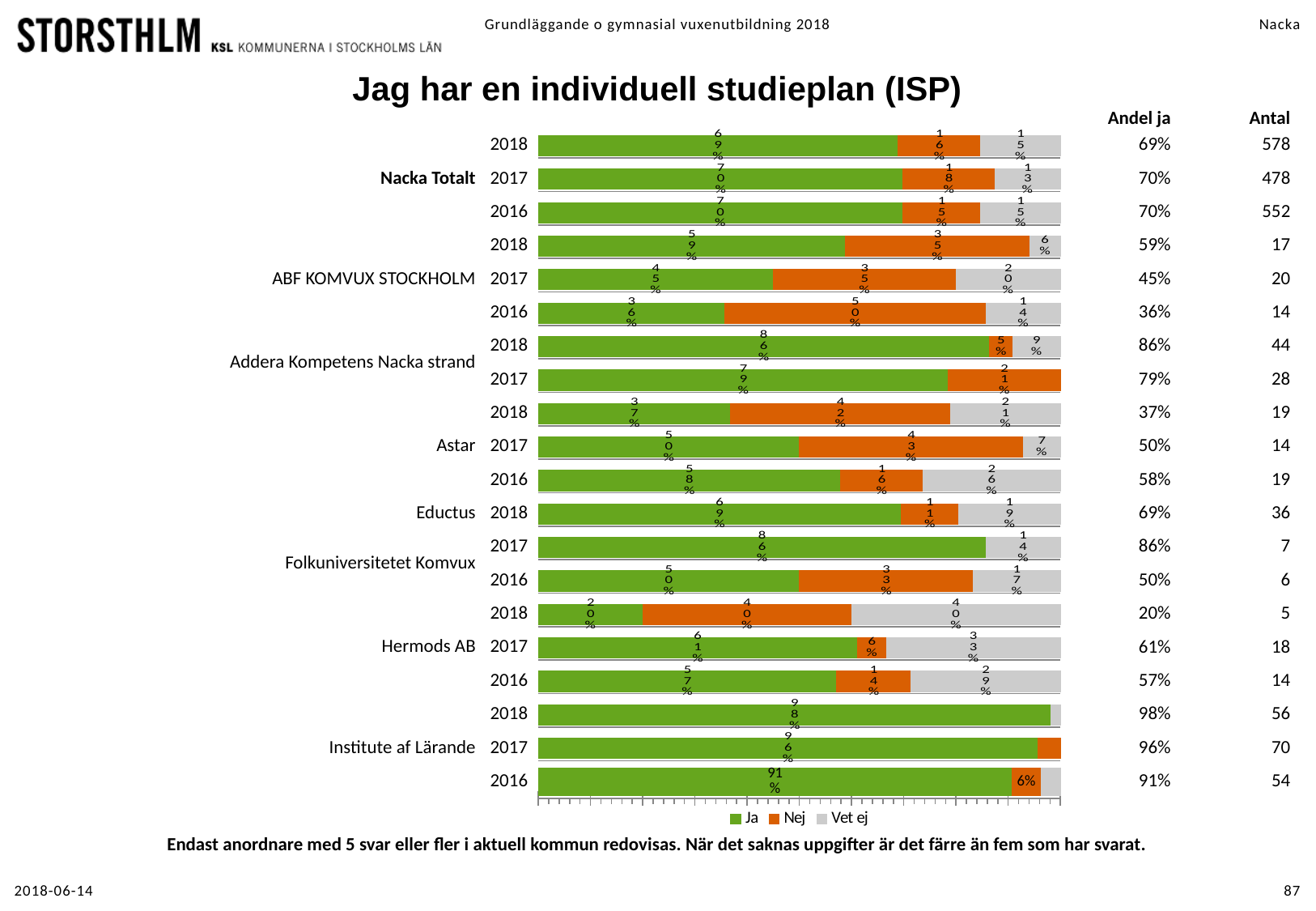
What is the Vet ej share for Hermods AB in 2017? 33% What is the Antal value for Institute af Lärande in 2017? 70 How many series does the legend list? 3 For Nacka Totalt 2018, what is the difference between the Ja share and the Nej share? 53 percentage points What kind of chart is shown on the slide? Bar chart What is the Ja share for Nacka Totalt in 2018? 69% For Astar 2018, which is larger, the Ja share or the Nej share? Nej Which row has the highest Andel ja? Institute af Lärande 2018 Does the Ja share for Institute af Lärande rise or fall from 2016 to 2018? Rises Which row has the lowest Andel ja? Hermods AB 2018 What are the legend entries of the chart? Ja, Nej, Vet ej What is the Nej share for ABF KOMVUX STOCKHOLM in 2016? 50%